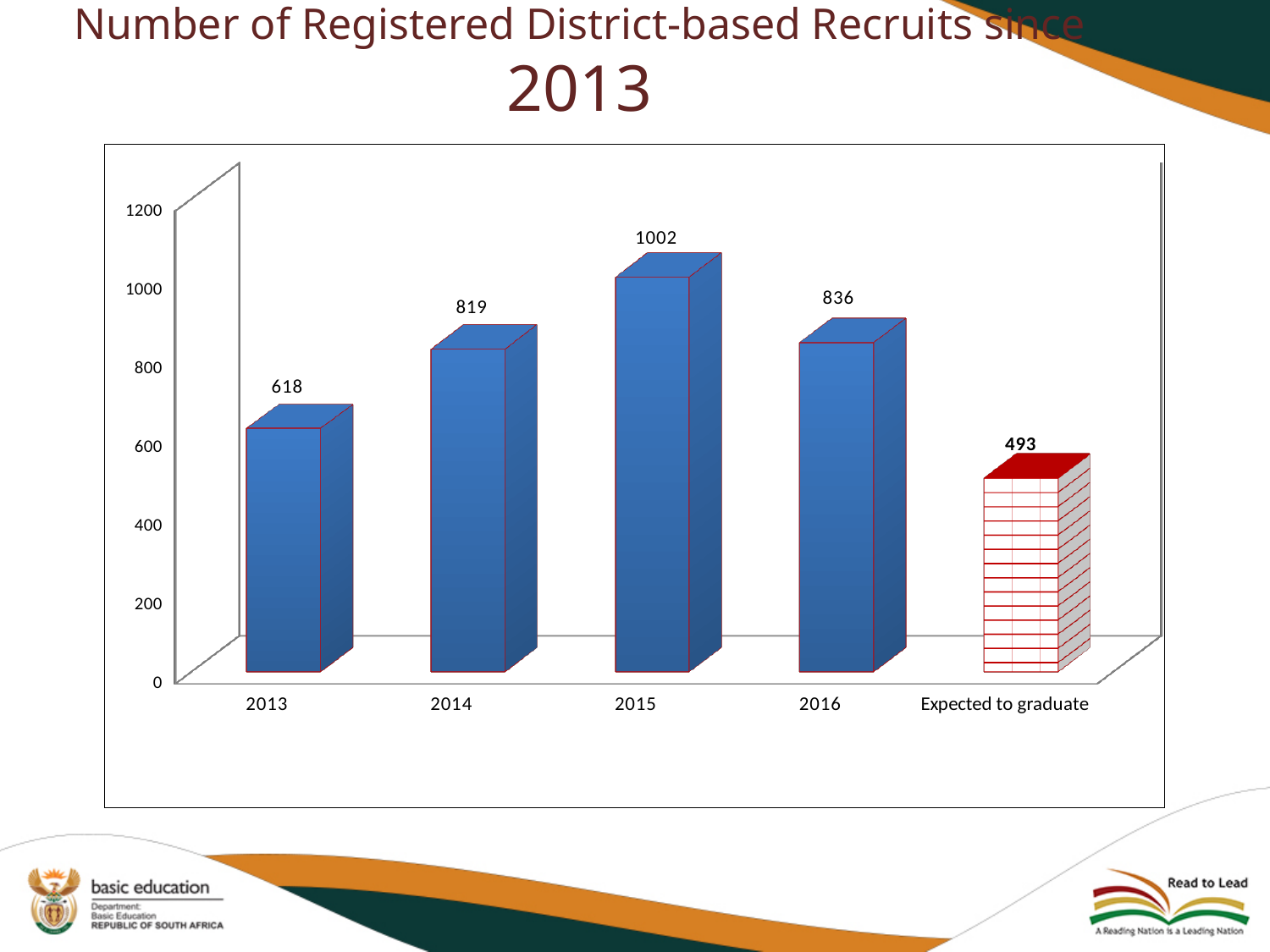
What is the difference between the values for 2015 and 2016? 166 Which category has the highest value? 2015 What is the number of registered district-based recruits for 2013? 618 How many bars are shown in the chart? 5 Which category has the lowest value? Expected to graduate What kind of chart is shown on the slide? Bar chart Which bar is coloured differently from the others? Expected to graduate Which is larger, the value for 2014 or the value for 2016? 2016 What is the difference between the values for 2014 and 2013? 201 What is the value shown for 2015? 1002 Is the value for 2013 greater or less than 800? less What is the value shown for the 'Expected to graduate' bar? 493